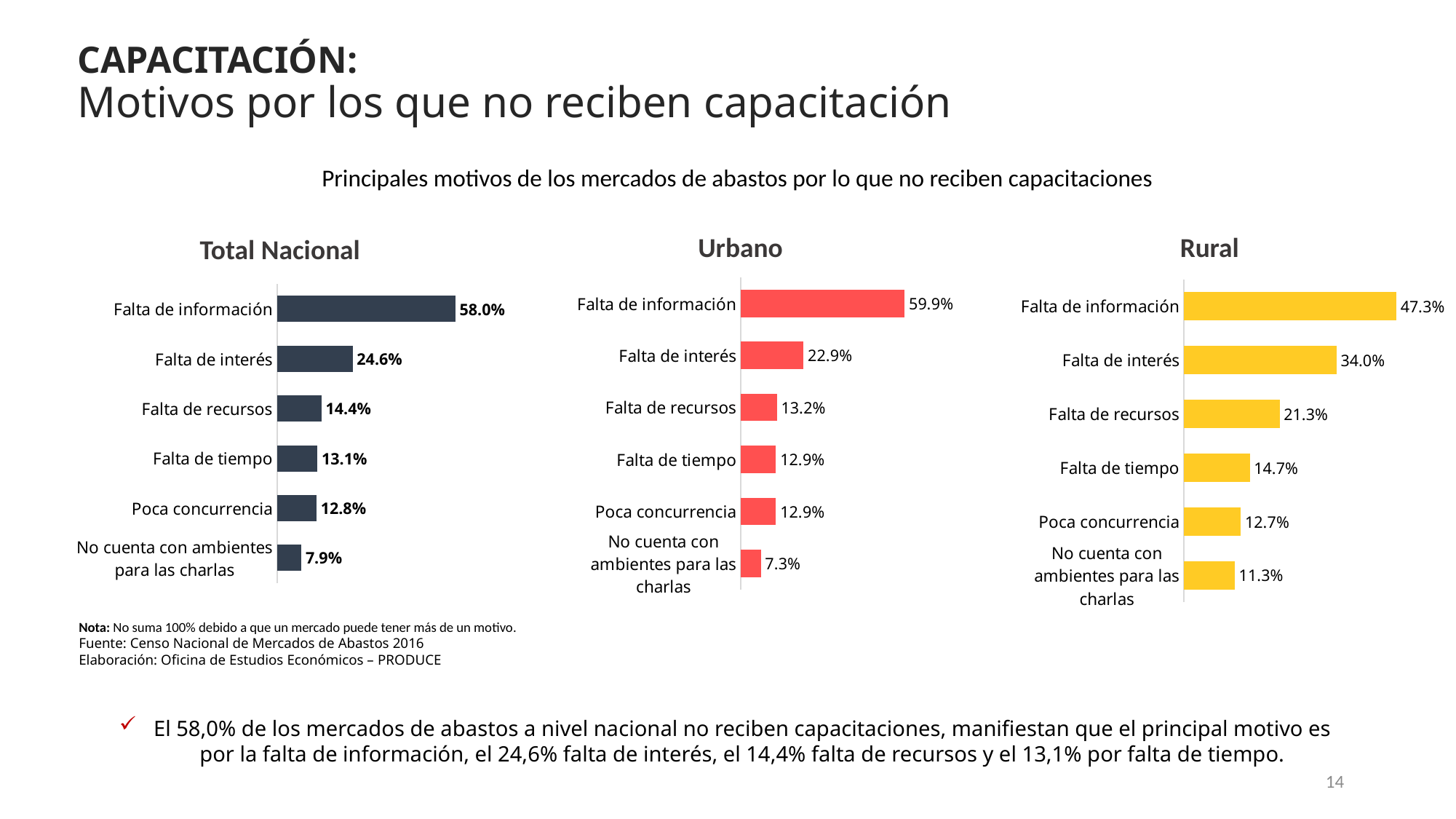
In the Urbano chart, what is the value for Falta de interés? 22.9% What type of chart is the Urbano chart? Bar chart In the Total Nacional chart, what is the value for Falta de información? 58.0% In the Total Nacional chart, what is the difference between Falta de información and Falta de interés? 33.4% What colour are the bars in the Rural chart? Yellow How many categories does the Total Nacional chart show? 6 Which is larger: Falta de información in the Urbano chart or Falta de información in the Rural chart? Urbano In the Rural chart, what is the difference between Falta de interés and Falta de tiempo? 19.3% In the Total Nacional chart, what is the value for Poca concurrencia? 12.8% In the Urbano chart, which category has the lowest value? No cuenta con ambientes para las charlas In the Rural chart, what is the value for Falta de recursos? 21.3% In the Rural chart, which category has the highest value? Falta de información